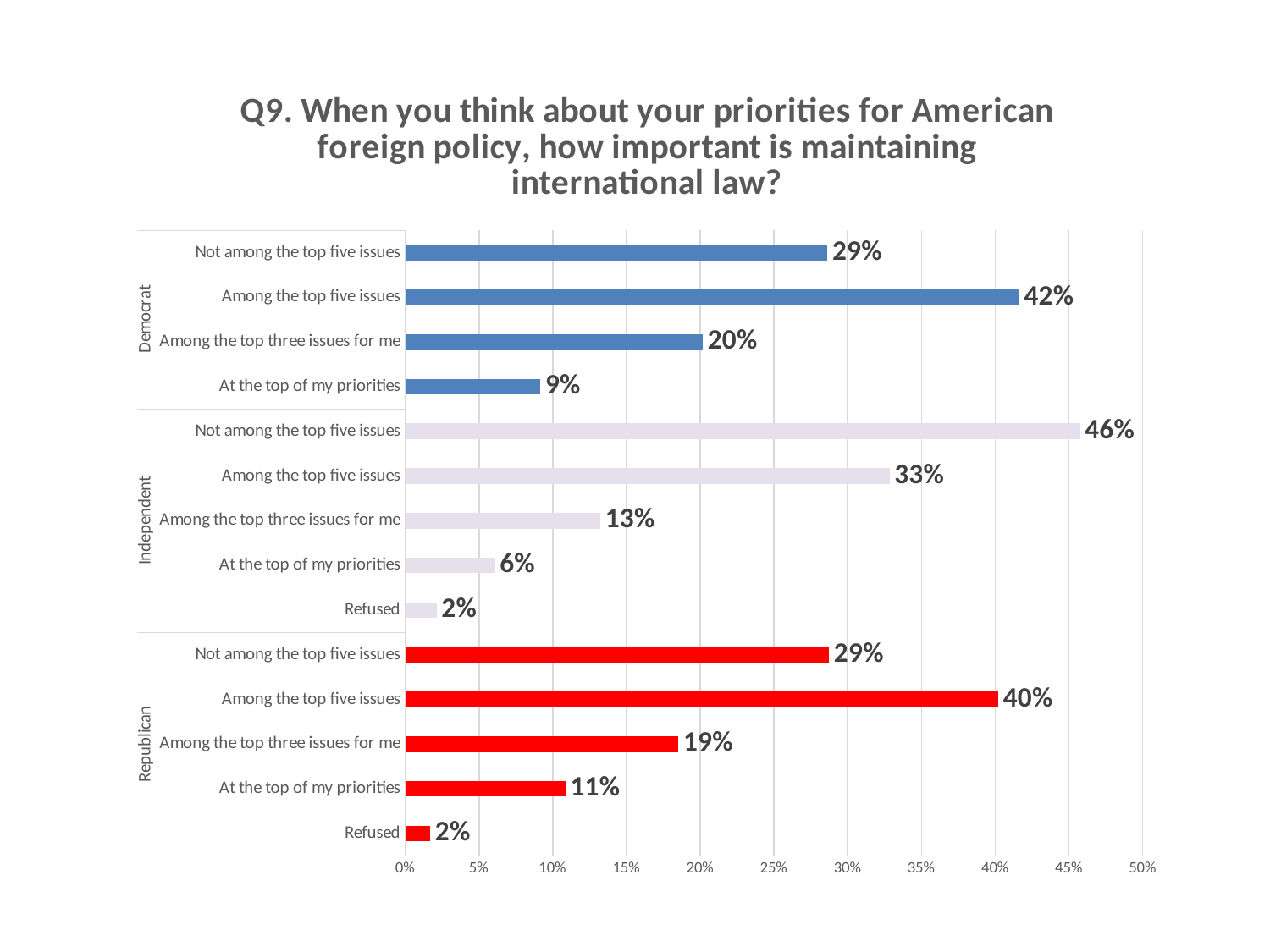
What percentage of Democrats said maintaining international law is among the top five issues? 42% What is the difference between the Democrat and Republican values for 'Among the top five issues'? 2% What colour are the bars for the Republican group? Red What percentage of Independents said maintaining international law is not among the top five issues? 46% How many bars are plotted for the Republican group? 5 Which is larger: the Democrat value for 'Among the top three issues for me' or the Independent value for the same response? Democrat How many bars are plotted for the Democrat group? 4 What kind of chart is shown on the slide? Bar chart What is the total of the Independent values for 'At the top of my priorities' and 'Refused'? 8% Which response has the highest value among Independents? Not among the top five issues Which response has the lowest value among Democrats? At the top of my priorities What percentage of Republicans said maintaining international law is at the top of their priorities? 11%